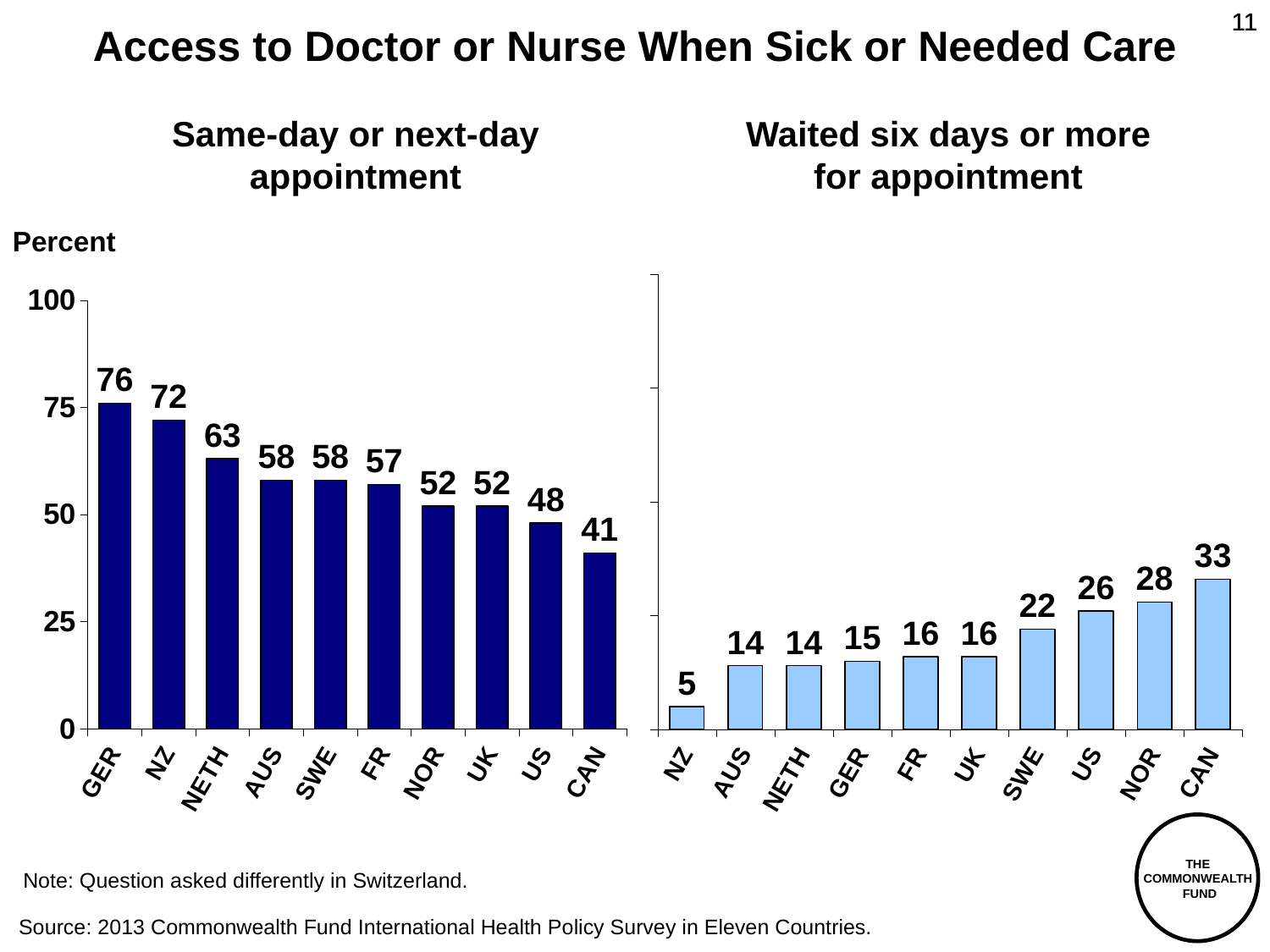
In the 'Waited six days or more for appointment' chart, what is the difference between CAN and NZ? 28 How many countries are shown in the 'Same-day or next-day appointment' chart? 10 In the 'Waited six days or more for appointment' chart, do the values rise or fall from left to right? Rise In the 'Same-day or next-day appointment' chart, what is the value for GER? 76 In the 'Waited six days or more for appointment' chart, which country has the highest value? CAN In the 'Same-day or next-day appointment' chart, what is the value for US? 48 What kind of chart is the 'Waited six days or more for appointment' chart? Bar chart In the 'Waited six days or more for appointment' chart, which country has the lowest value? NZ In the 'Same-day or next-day appointment' chart, which country has the lowest value? CAN In the 'Same-day or next-day appointment' chart, what is the difference between GER and CAN? 35 In the 'Same-day or next-day appointment' chart, which is larger, the value for NZ or the value for US? NZ In the 'Waited six days or more for appointment' chart, what is the value for CAN? 33